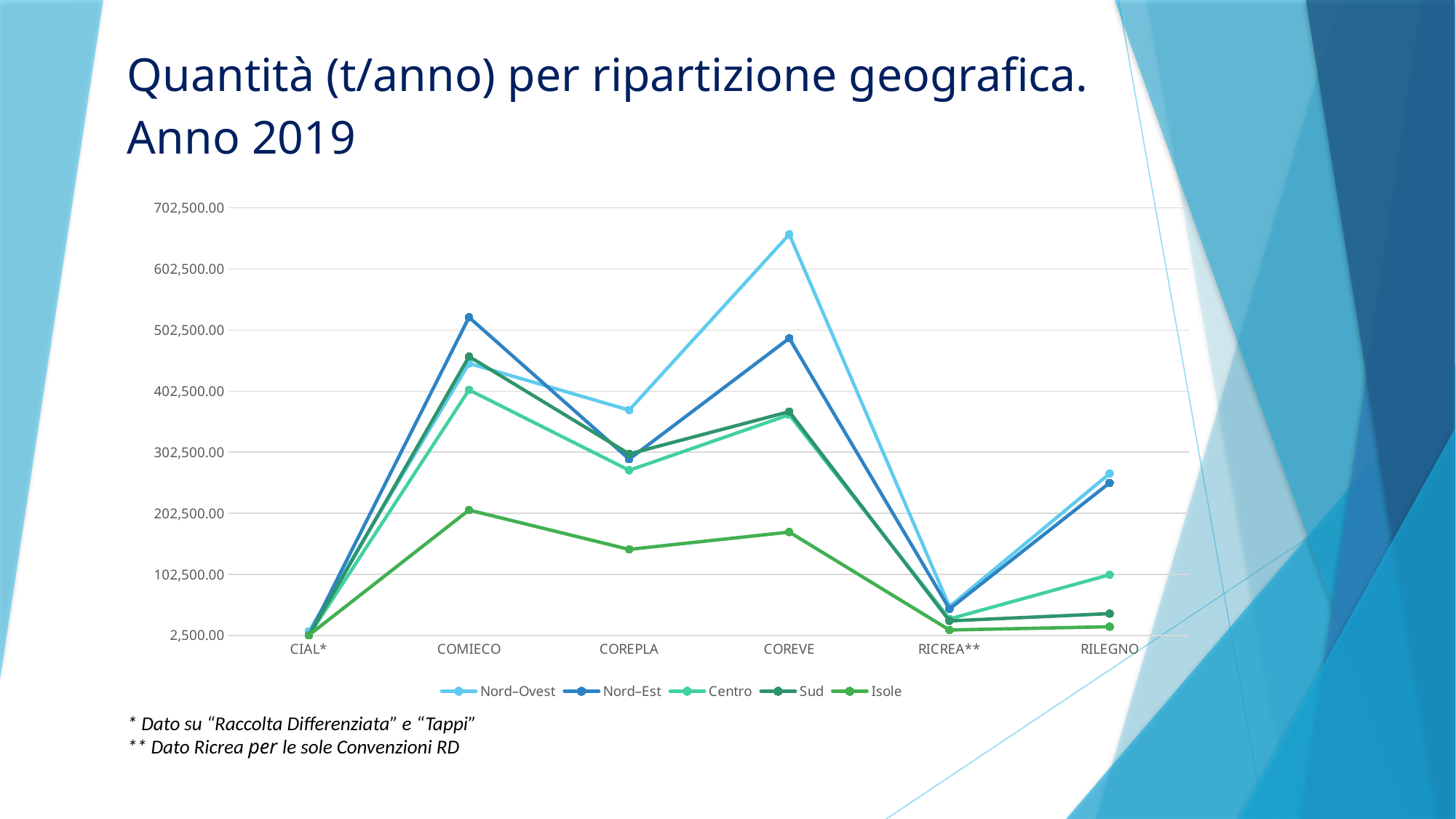
How many categories are shown on the x axis? 6 For which category is the Nord-Ovest value highest? COREVE Is the Nord-Ovest value for COREPLA greater or less than 302,500.00? greater Which series has the lowest value at COMIECO? Isole Is the Nord-Ovest value for COREVE greater or less than 602,500.00? greater At RILEGNO, which is larger: the Centro value or the Sud value? Centro At COREVE, which is larger: the Nord-Ovest value or the Nord-Est value? Nord-Ovest What kind of chart is shown on the slide? line chart For which category is the Nord-Est value lowest? CIAL* How many series does the legend list? 5 Does the Isole line rise or fall from COREVE to RICREA**? fall Is the Isole value for COREPLA greater or less than 202,500.00? less